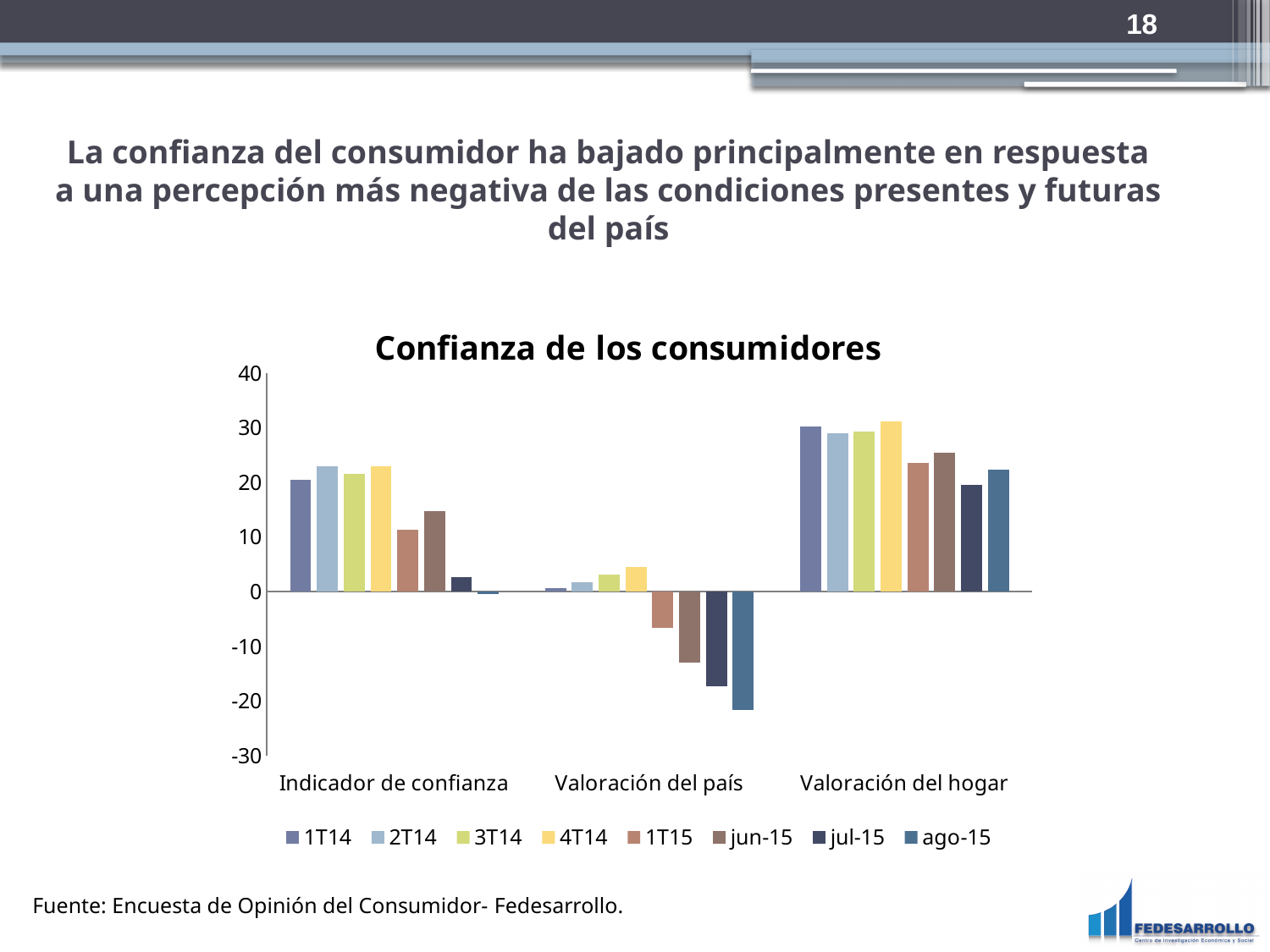
In Indicador de confianza, which is larger: the value for 1T15 or for jun-15? jun-15 How many series does the legend of the chart list? 8 In Valoración del hogar, which is larger: the value for jul-15 or for ago-15? ago-15 Do the values for Valoración del país rise or fall from 1T15 to ago-15? fall Is the value for 4T14 in Valoración del hogar greater or less than 20? greater What is the title of the chart? Confianza de los consumidores Is the value for jul-15 in Indicador de confianza greater or less than 10? less Is the value for ago-15 in Valoración del país greater or less than -10? less Which series has the lowest value in the Valoración del país category? ago-15 What kind of chart is shown on the slide? Bar chart Which category has the highest values overall in the chart? Valoración del hogar How many categories are shown on the x axis of the chart? 3